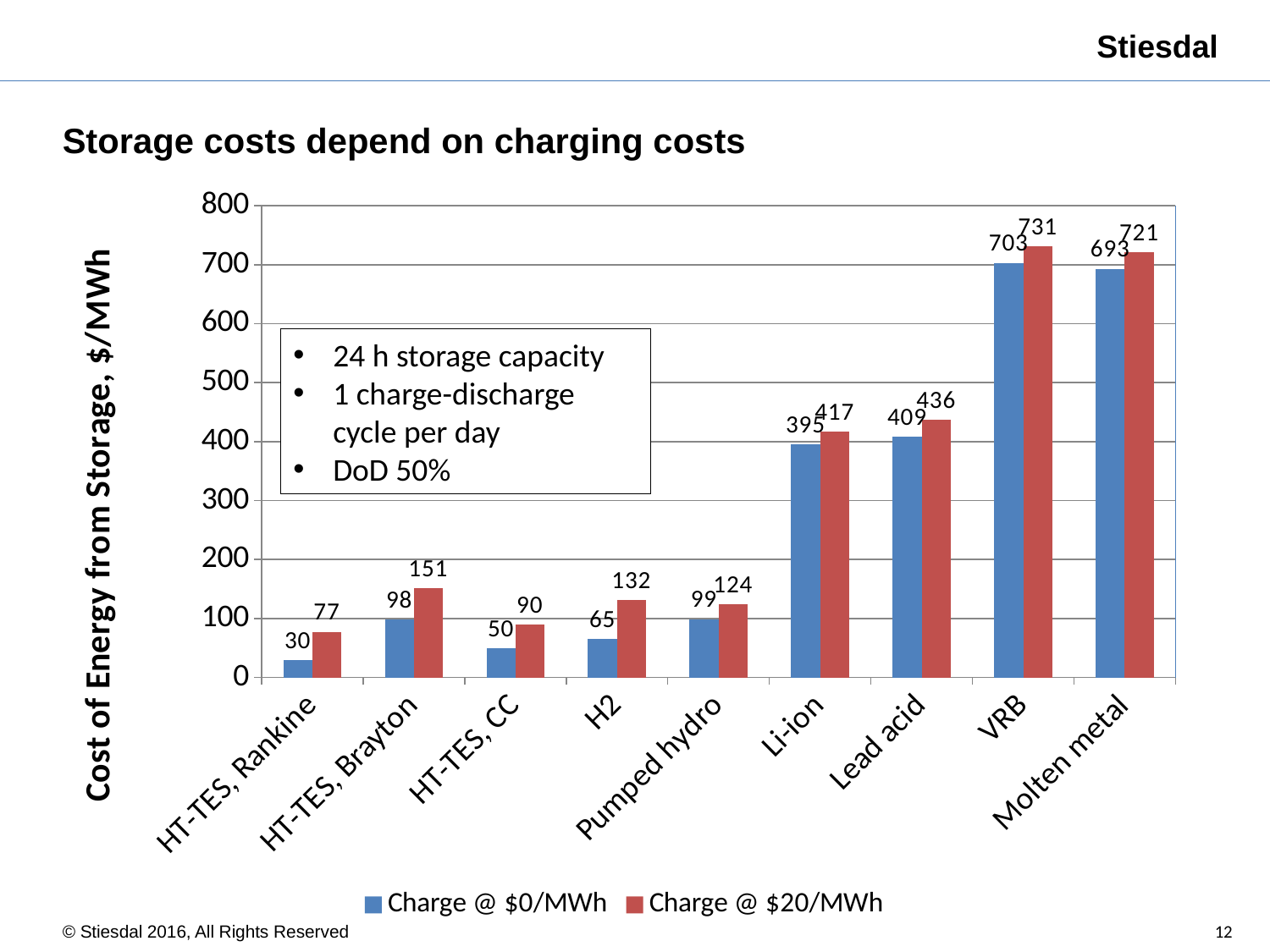
How many series does the legend list? 2 What is the difference between the Charge @ $20/MWh and Charge @ $0/MWh values for Lead acid? 27 What is the y-axis title of the chart? Cost of Energy from Storage, $/MWh Which colour represents the Charge @ $20/MWh series? Red What is the value for Pumped hydro in the Charge @ $0/MWh series? 99 What is the value for VRB in the Charge @ $20/MWh series? 731 How many categories are shown on the x axis? 9 Which category has the lowest value in the Charge @ $0/MWh series? HT-TES, Rankine What is the value for HT-TES, Rankine in the Charge @ $0/MWh series? 30 Which is larger: the Charge @ $0/MWh value for HT-TES, Brayton or for H2? HT-TES, Brayton What kind of chart is shown on the slide? Bar chart Which category has the highest value in the Charge @ $20/MWh series? VRB